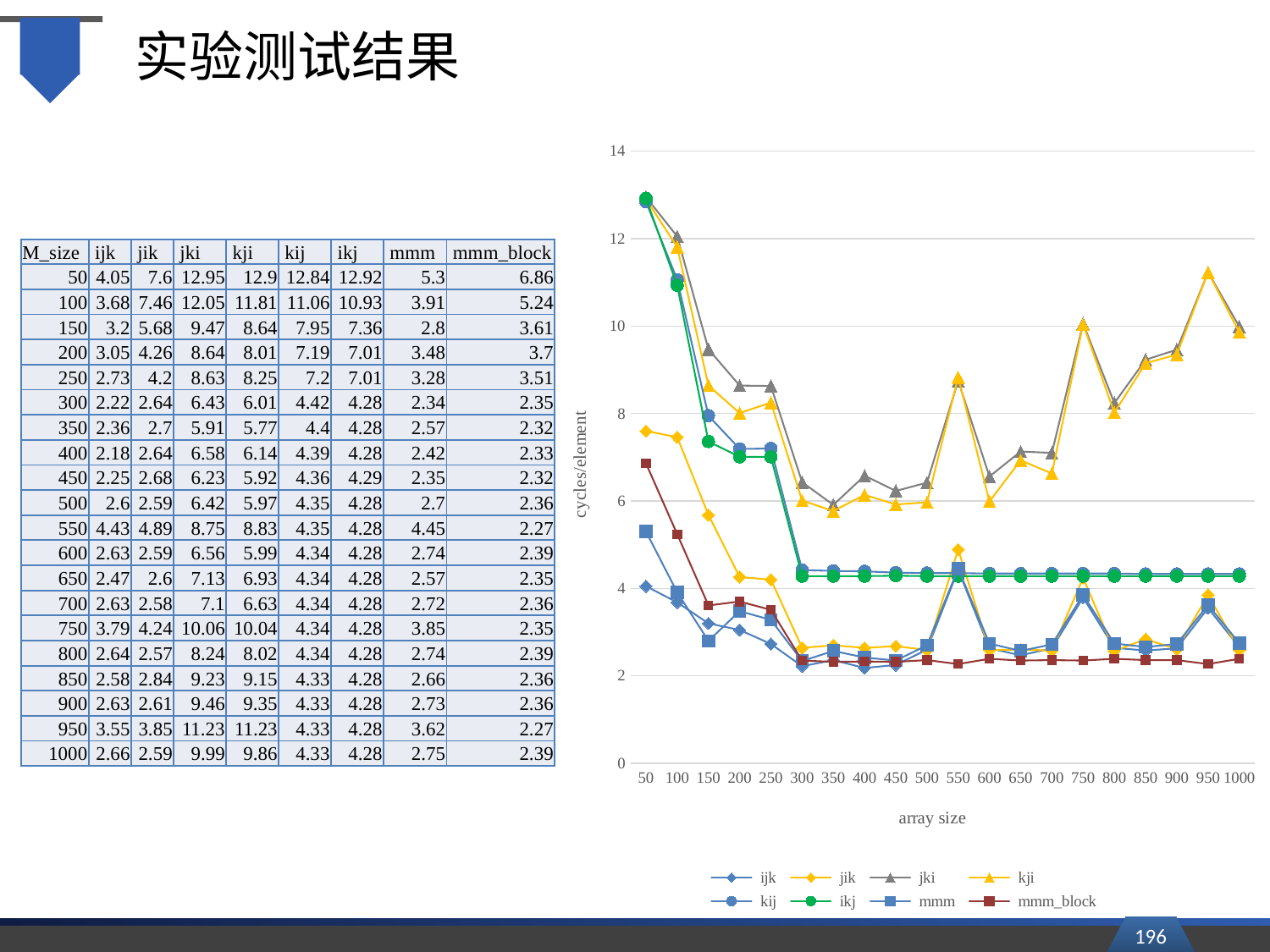
How many array-size points are plotted along the x axis of the chart? 20 What is the label of the y axis of the chart? cycles/element Is the value for jki at array size 950 greater or less than 10? greater What kind of chart is shown on the slide? line chart What is the cycles/element value of kij at array size 1000? 4.33 At array size 1000, which is larger, the kij value or the mmm value? kij Which series has the lowest cycles/element at array size 50? ijk Which series has the highest cycles/element at array size 50? jki How many series does the chart legend list? 8 What is the label of the x axis of the chart? array size What is the difference between the kij value at array size 50 and at array size 1000? 8.51 What is the cycles/element value of mmm_block at array size 1000? 2.39